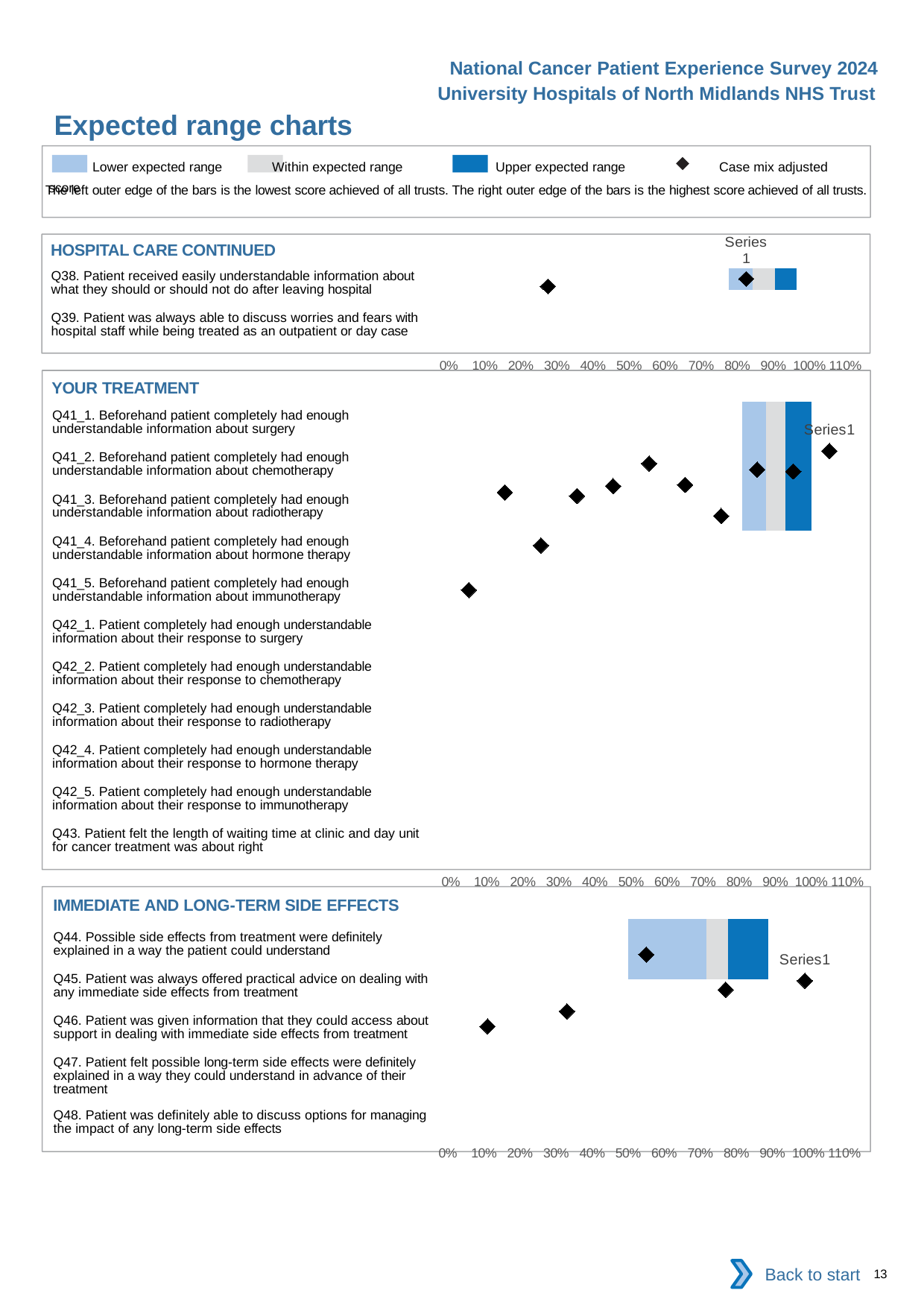
What kind of chart is used on this slide to show the expected ranges? bar chart with diamond markers How many questions are listed in the HOSPITAL CARE CONTINUED chart? 2 How many entries does the legend at the top of the slide list? 4 In the YOUR TREATMENT chart, is the lowest plotted case mix adjusted score greater or less than 20%? less How many questions are listed in the YOUR TREATMENT chart? 11 How many questions are listed in the IMMEDIATE AND LONG-TERM SIDE EFFECTS chart? 5 In the IMMEDIATE AND LONG-TERM SIDE EFFECTS chart, is the lowest plotted case mix adjusted score greater or less than 30%? less In the YOUR TREATMENT chart, is the highest plotted case mix adjusted score greater or less than 80%? greater What is the highest tick label shown on the x axis of the charts? 110% According to the legend, what symbol marks the case mix adjusted score? a diamond